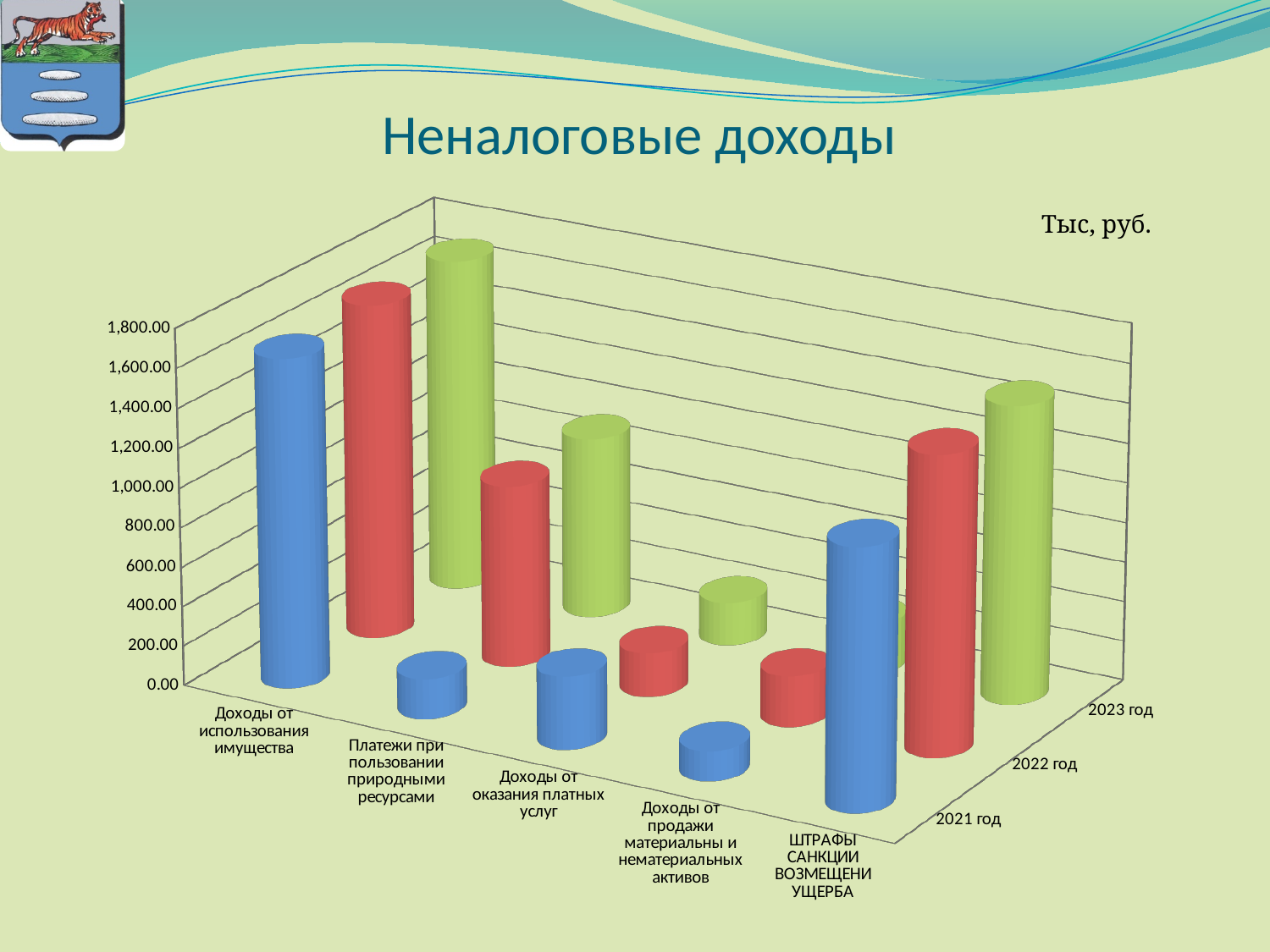
How many income categories are shown along the category axis of the chart? 5 Is the 2021 год value for Штрафы санкции возмещение ущерба greater or less than 800.00? greater What is the title of the chart? Неналоговые доходы Which is larger for 2021 год: Доходы от использования имущества or Платежи при пользовании природными ресурсами? Доходы от использования имущества Is the 2023 год value for Доходы от использования имущества greater or less than 1,200.00? greater What unit is indicated for the values on the chart? Тыс, руб. How many years (series) are plotted on the chart? 3 Which is larger for 2023 год: Штрафы санкции возмещение ущерба or Доходы от продажи материальных и нематериальных активов? Штрафы санкции возмещение ущерба Is the 2021 год value for Платежи при пользовании природными ресурсами greater or less than 600.00? less Which category has the highest value for 2023 год? Доходы от использования имущества What kind of chart is shown on the slide? bar chart